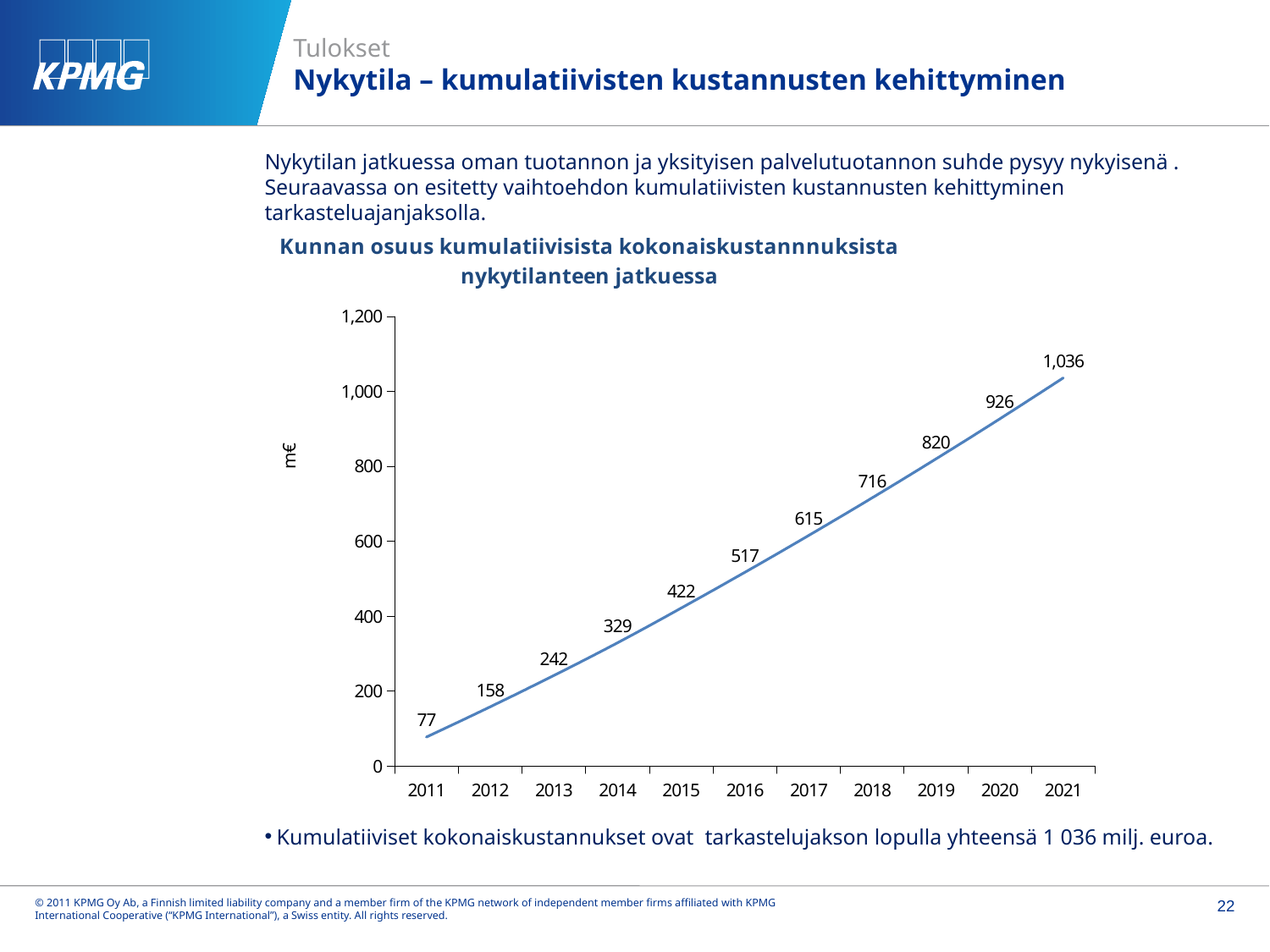
What kind of chart is shown? line chart What is the difference between the values for 2013 and 2012? 84 What is the value for 2011? 77 What is the difference between the values for 2021 and 2020? 110 Which year has the lowest value? 2011 Which is larger, the value for 2016 or the value for 2017? 2017 Which year has the highest value? 2021 Do the values rise or fall from 2011 to 2021? rise What is the value for 2018? 716 How many years are plotted on the x axis? 11 What is the value for 2021? 1,036 What is the value for 2015? 422